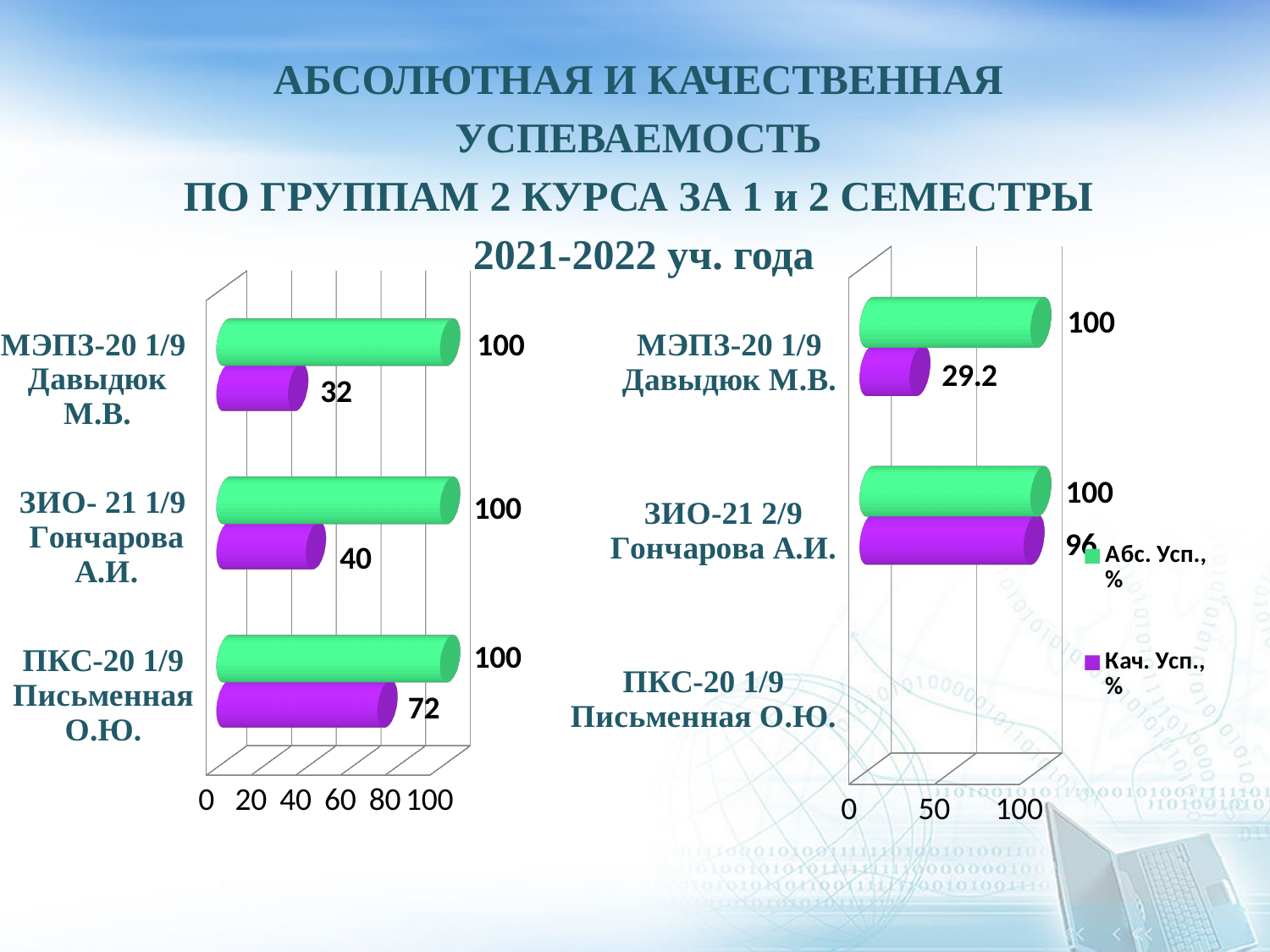
In the left chart, what is the Кач. Усп., % value for ПКС-20 1/9 Письменная О.Ю.? 72 In the left chart, which group has the lowest Кач. Усп., % value? МЭПЗ-20 1/9 Давыдюк М.В. In the left chart, what is the difference between the Кач. Усп., % values of ПКС-20 1/9 Письменная О.Ю. and ЗИО- 21 1/9 Гончарова А.И.? 32 In the right chart, what is the Кач. Усп., % value for ЗИО-21 2/9 Гончарова А.И.? 96 In the left chart, what is the Абс. Усп., % value for ЗИО- 21 1/9 Гончарова А.И.? 100 What type of chart is the left chart? Bar chart In the left chart, what is the Кач. Усп., % value for МЭПЗ-20 1/9 Давыдюк М.В.? 32 In the right chart, which is larger: the Кач. Усп., % value for ЗИО-21 2/9 Гончарова А.И. or for МЭПЗ-20 1/9 Давыдюк М.В.? ЗИО-21 2/9 Гончарова А.И. In the right chart, what is the Кач. Усп., % value for МЭПЗ-20 1/9 Давыдюк М.В.? 29.2 How many series does the legend on the slide list? 2 In the right chart, what is the difference between the Абс. Усп., % and Кач. Усп., % values for МЭПЗ-20 1/9 Давыдюк М.В.? 70.8 In the left chart, which group has the highest Кач. Усп., % value? ПКС-20 1/9 Письменная О.Ю.